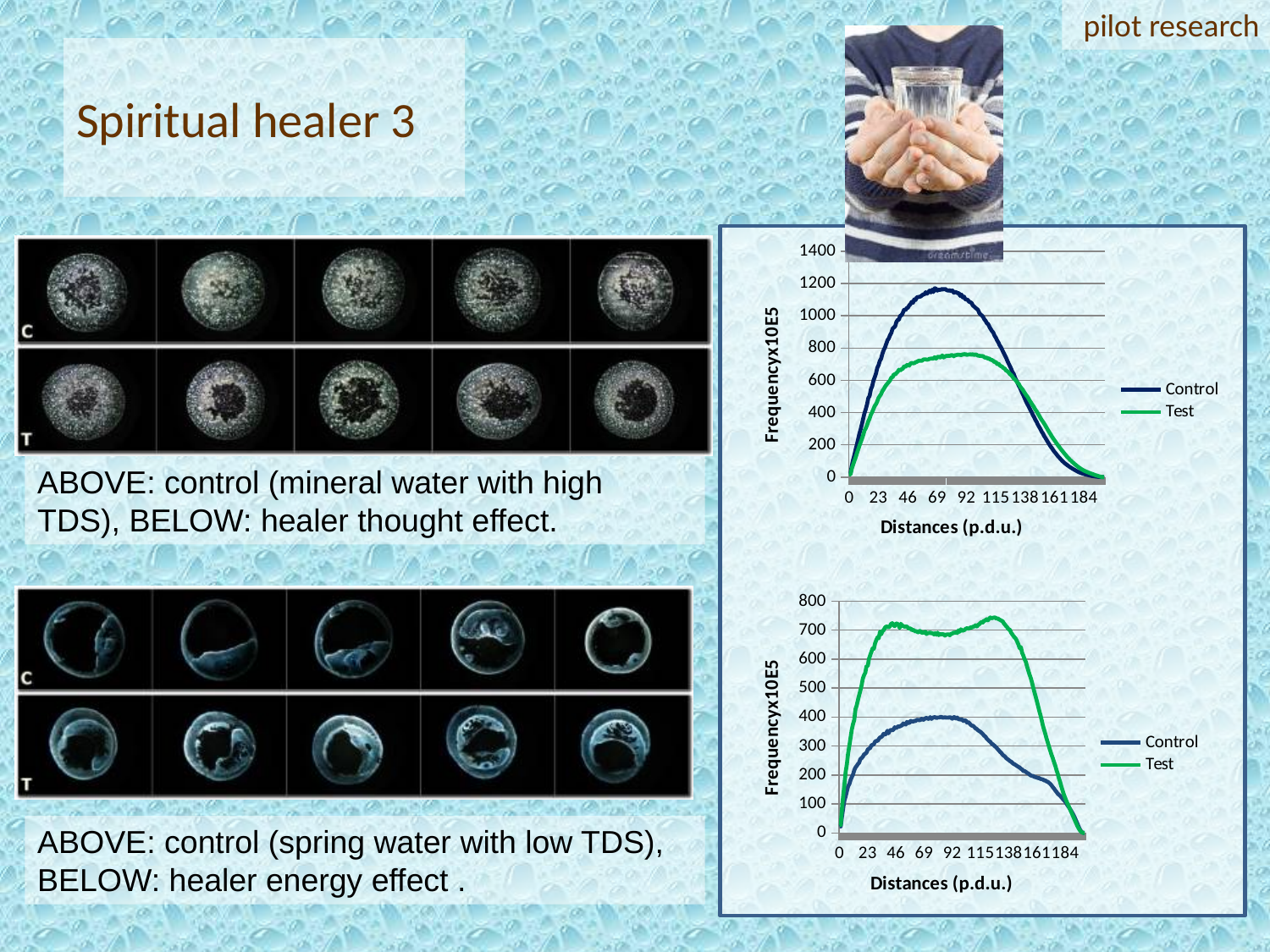
In the bottom chart, is the peak value of the Test series greater or less than 600? greater How many series does the legend of the top chart list? 2 In the top chart, do the values of the Control series rise or fall between distance 138 and distance 184? fall In the top chart, is the peak value of the Test series greater or less than 800? less In the top chart, which series reaches the higher peak, Control or Test? Control What are the two series named in the legend of the bottom chart? Control and Test In the top chart, is the peak value of the Control series greater or less than 1000? greater What is the label of the x axis on the top chart? Distances (p.d.u.) What kind of chart is the top chart on the right of the slide? line chart How many tick labels are shown on the x axis of the bottom chart? 9 In the bottom chart, which series reaches the higher peak, Control or Test? Test